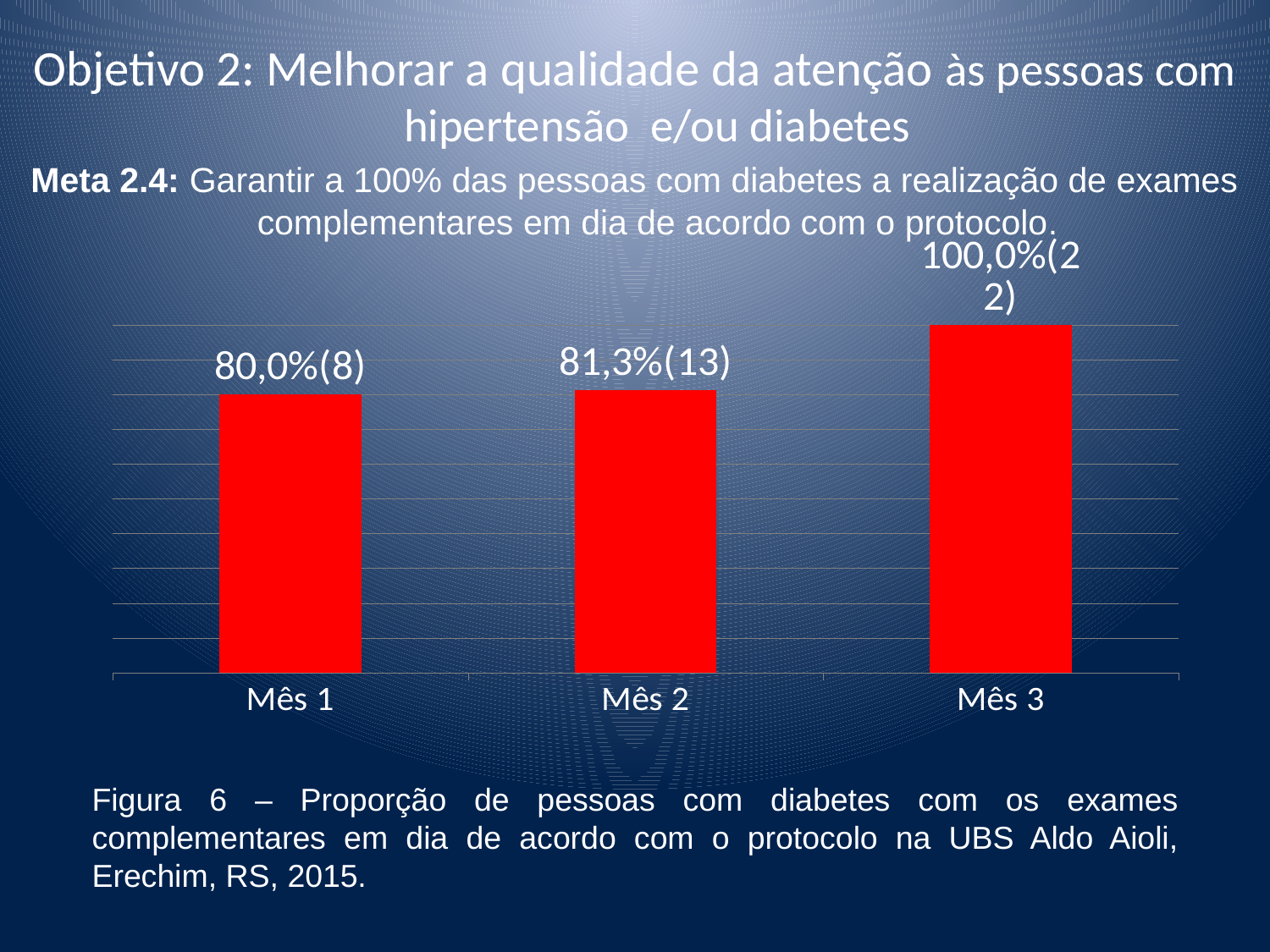
What kind of chart is shown on the slide? Bar chart Which month has the lowest value? Mês 1 What colour are the bars in the chart? Red Which month has the highest value? Mês 3 What is the difference in percentage points between Mês 3 and Mês 1? 20,0 percentage points What is the value shown for Mês 3? 100,0%(22) Do the values rise or fall from Mês 1 to Mês 3? Rise What is the difference in percentage points between Mês 2 and Mês 1? 1,3 percentage points How many months (categories) are shown on the chart? 3 Which is larger, the value for Mês 3 or the value for Mês 2? Mês 3 What is the value shown for Mês 2? 81,3%(13) What is the value shown for Mês 1? 80,0%(8)